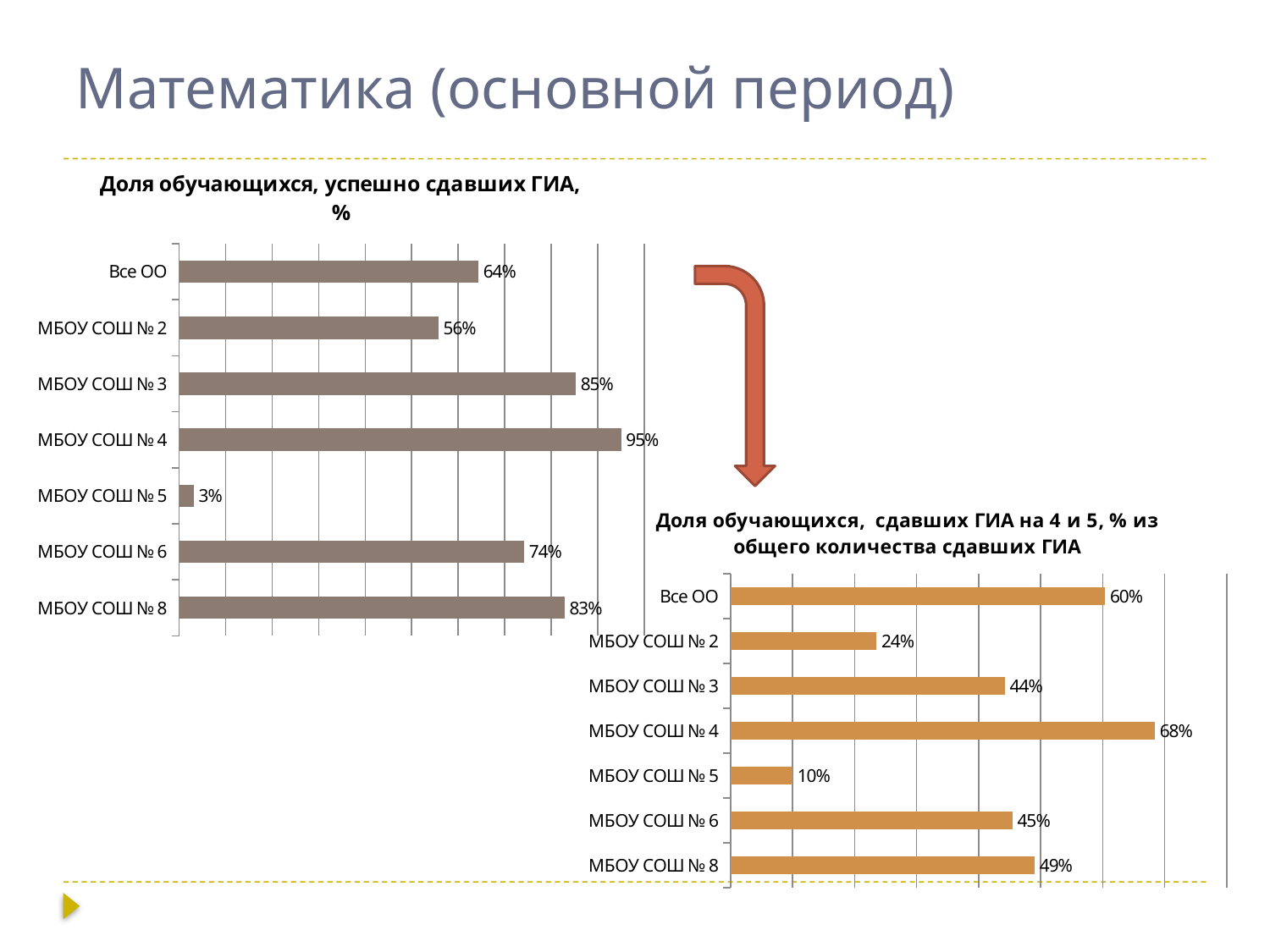
In the left chart 'Доля обучающихся, успешно сдавших ГИА, %', which category has the lowest value? МБОУ СОШ № 5 In the right chart 'Доля обучающихся, сдавших ГИА на 4 и 5', which is larger: the value for МБОУ СОШ № 2 or МБОУ СОШ № 3? МБОУ СОШ № 3 In the left chart 'Доля обучающихся, успешно сдавших ГИА, %', what is the difference between the values for МБОУ СОШ № 4 and МБОУ СОШ № 2? 39% In the right chart 'Доля обучающихся, сдавших ГИА на 4 и 5', what is the value for МБОУ СОШ № 8? 49% In the right chart 'Доля обучающихся, сдавших ГИА на 4 и 5', which category has the highest value? МБОУ СОШ № 4 In the left chart 'Доля обучающихся, успешно сдавших ГИА, %', what is the value for МБОУ СОШ № 3? 85% What type of chart is the left chart 'Доля обучающихся, успешно сдавших ГИА, %'? Bar chart In the right chart 'Доля обучающихся, сдавших ГИА на 4 и 5', what is the difference between the values for МБОУ СОШ № 6 and МБОУ СОШ № 5? 35% What colour are the bars in the right chart 'Доля обучающихся, сдавших ГИА на 4 и 5'? Orange In the right chart 'Доля обучающихся, сдавших ГИА на 4 и 5', what is the value for Все ОО? 60% In the left chart 'Доля обучающихся, успешно сдавших ГИА, %', how many categories are shown? 7 In the left chart 'Доля обучающихся, успешно сдавших ГИА, %', which category has the highest value? МБОУ СОШ № 4